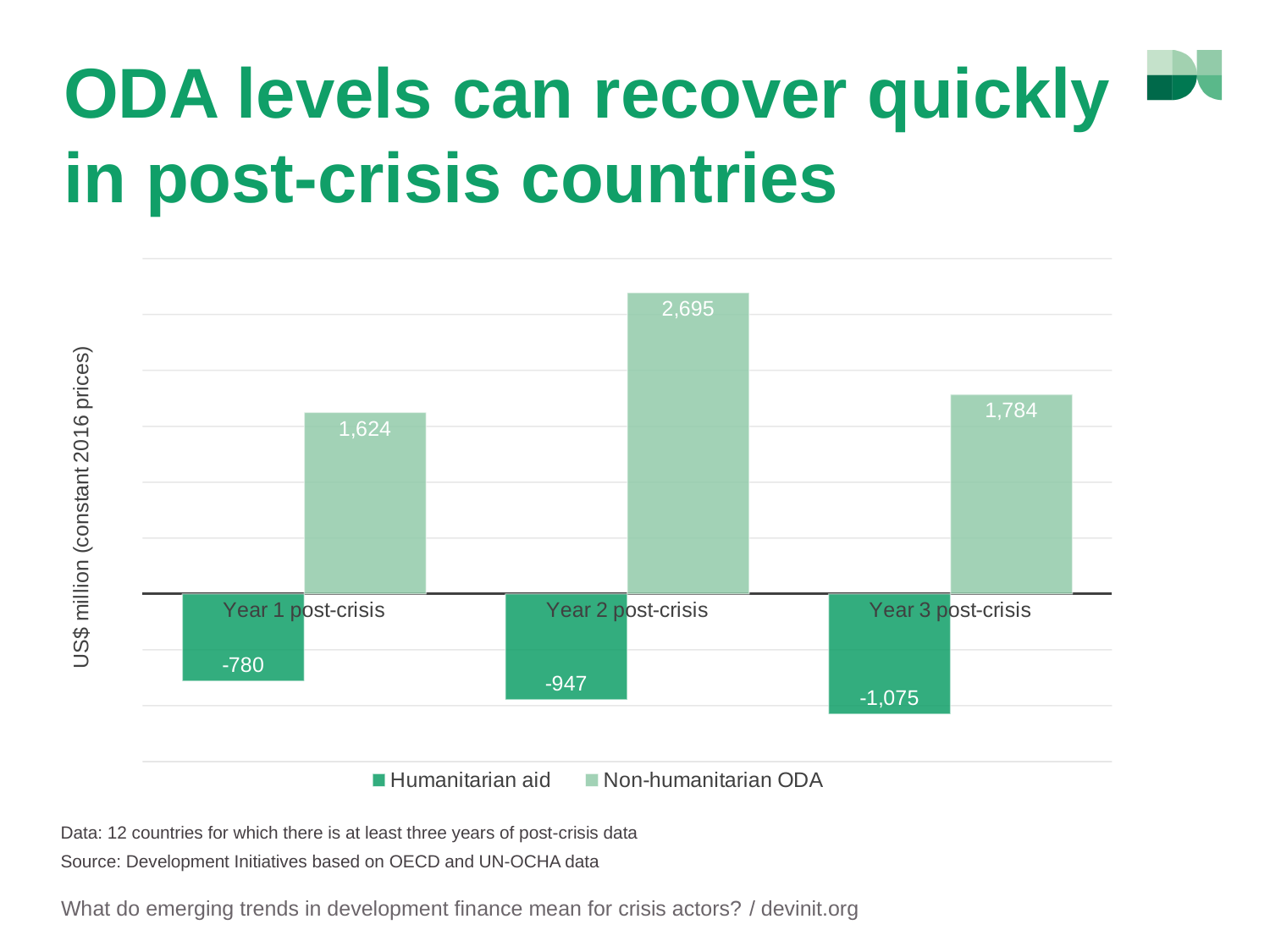
What is the label of the y axis? US$ million (constant 2016 prices) In which year is Non-humanitarian ODA highest? Year 2 post-crisis What kind of chart is shown on the slide? Bar chart Which is larger in absolute terms: Humanitarian aid in Year 1 post-crisis or Year 3 post-crisis? Year 3 post-crisis What is the value for Non-humanitarian ODA in Year 2 post-crisis? 2,695 What is the difference between Non-humanitarian ODA in Year 2 post-crisis and Year 3 post-crisis? 911 What is the value for Humanitarian aid in Year 2 post-crisis? -947 In which year is Non-humanitarian ODA lowest? Year 1 post-crisis What is the value for Non-humanitarian ODA in Year 1 post-crisis? 1,624 How many categories are shown on the x axis? 3 What is the value for Humanitarian aid in Year 3 post-crisis? -1,075 How many series does the legend list? 2